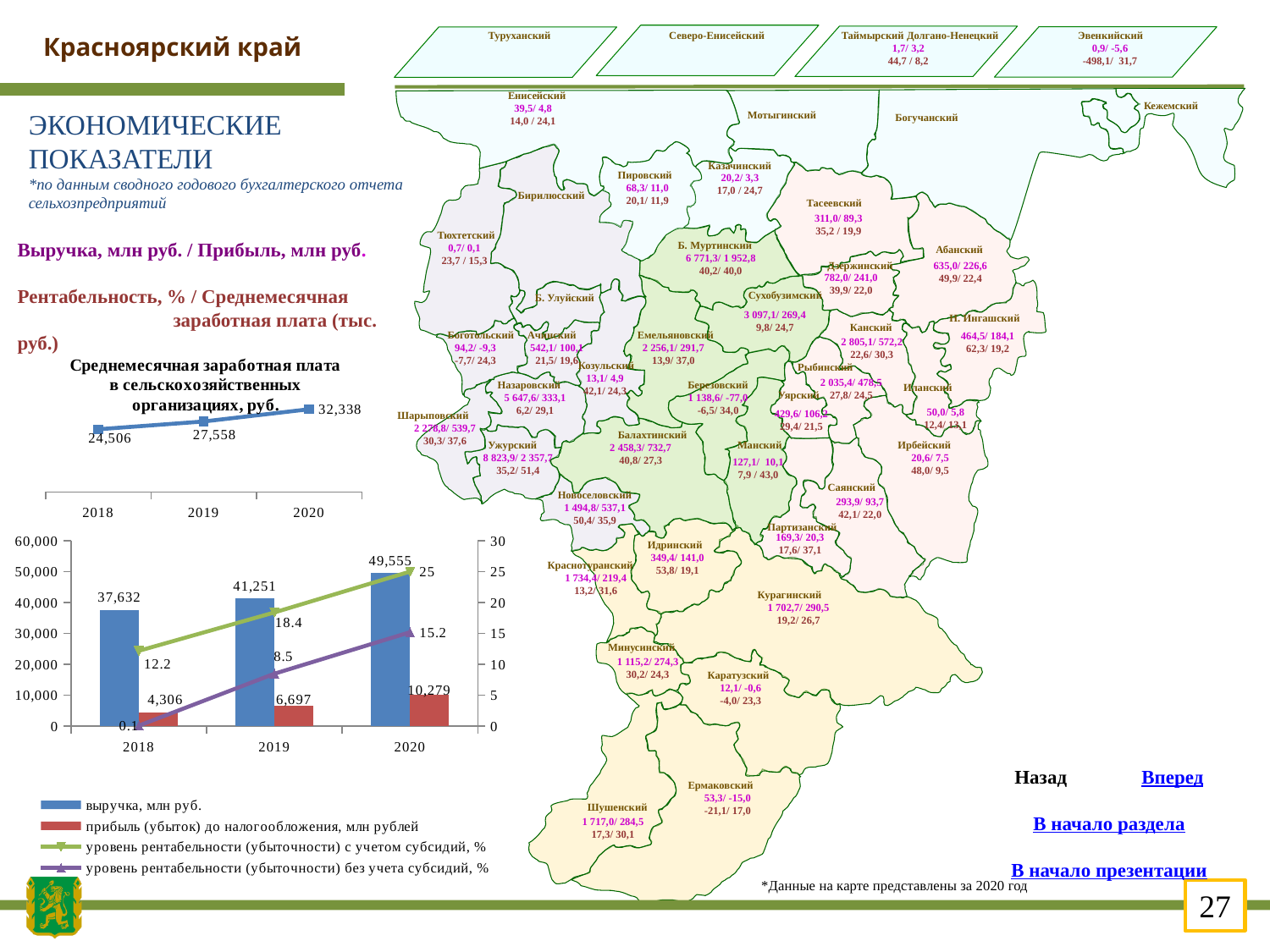
In the line chart titled 'Среднемесячная заработная плата в сельскохозяйственных организациях, руб.', what is the value for 2020? 32,338 In the lower-left combo chart, how many series does the legend list? 4 In the lower-left combo chart, what is the value of 'уровень рентабельности (убыточности) с учетом субсидий, %' for 2018? 12.2 In the line chart titled 'Среднемесячная заработная плата в сельскохозяйственных организациях, руб.', how many years are plotted? 3 In the lower-left combo chart, what is the value of 'уровень рентабельности (убыточности) без учета субсидий, %' for 2019? 8.5 In the lower-left combo chart, which year has the highest 'выручка, млн руб.'? 2020 In the line chart titled 'Среднемесячная заработная плата в сельскохозяйственных организациях, руб.', do the values rise or fall from 2018 to 2020? rise In the lower-left combo chart, what is the difference between 'выручка, млн руб.' in 2020 and in 2018? 11,923 In the line chart titled 'Среднемесячная заработная плата в сельскохозяйственных организациях, руб.', what is the value for 2018? 24,506 In the lower-left combo chart, which is larger in 2020: 'уровень рентабельности (убыточности) с учетом субсидий, %' or 'уровень рентабельности (убыточности) без учета субсидий, %'? уровень рентабельности (убыточности) с учетом субсидий, % In the lower-left combo chart, what is the value of 'выручка, млн руб.' for 2019? 41,251 In the lower-left combo chart, what is the value of 'прибыль (убыток) до налогообложения, млн рублей' for 2020? 10,279